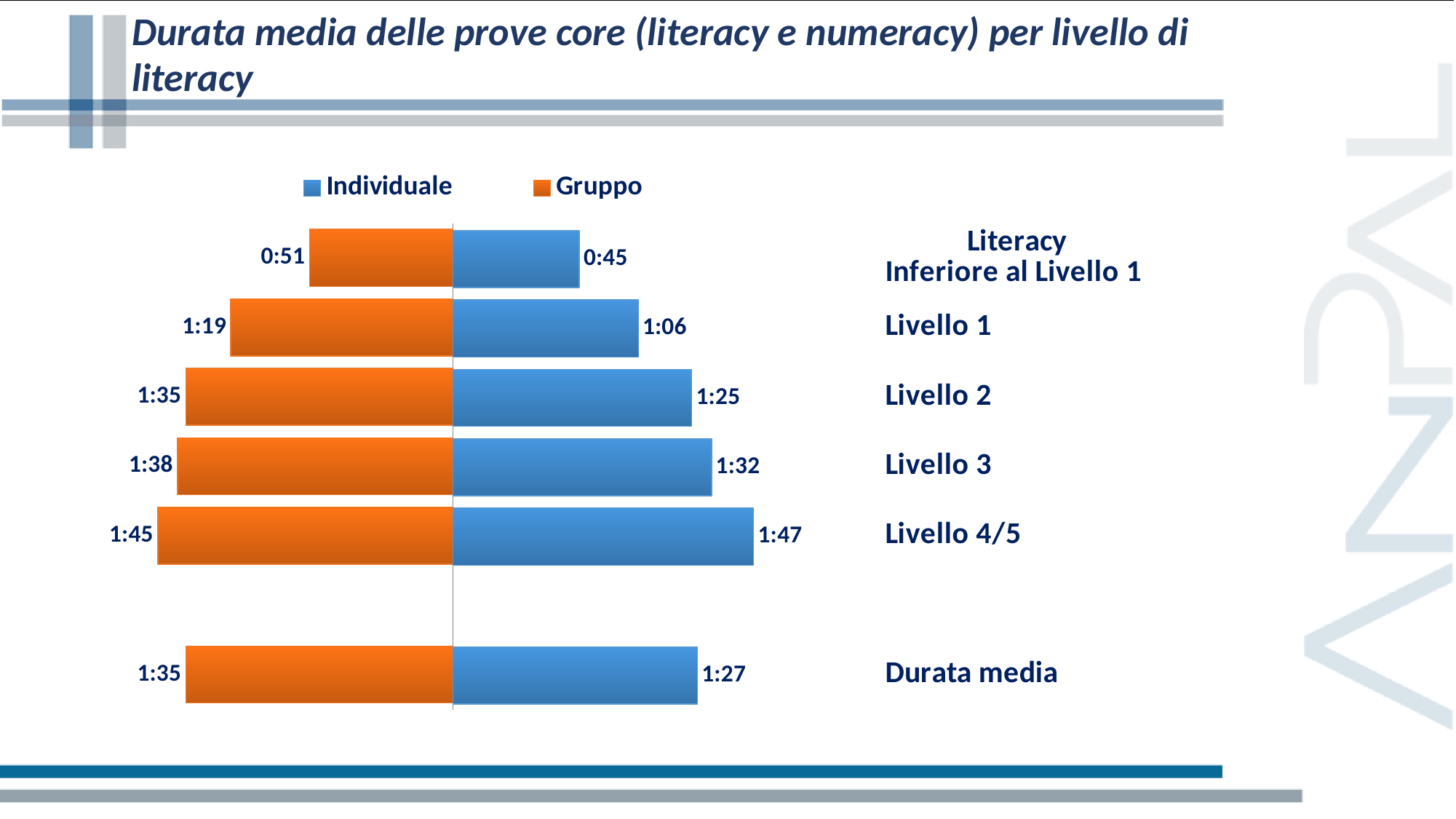
What is the Individuale value for Literacy Inferiore al Livello 1? 0:45 What is the difference between the Gruppo and Individuale values for Livello 1? 0:13 What is the Gruppo value for Livello 1? 1:19 For Livello 4/5, which is larger: the Gruppo value or the Individuale value? Individuale What is the Individuale value for Livello 2? 1:25 What kind of chart is shown on the slide? Bar chart What is the Gruppo value for Durata media? 1:35 How many series does the legend list? 2 How many categories are shown in the chart? 6 Which literacy level has the highest Individuale value? Livello 4/5 Which literacy level has the lowest Gruppo value? Literacy Inferiore al Livello 1 For Livello 3, which is larger: the Gruppo value or the Individuale value? Gruppo